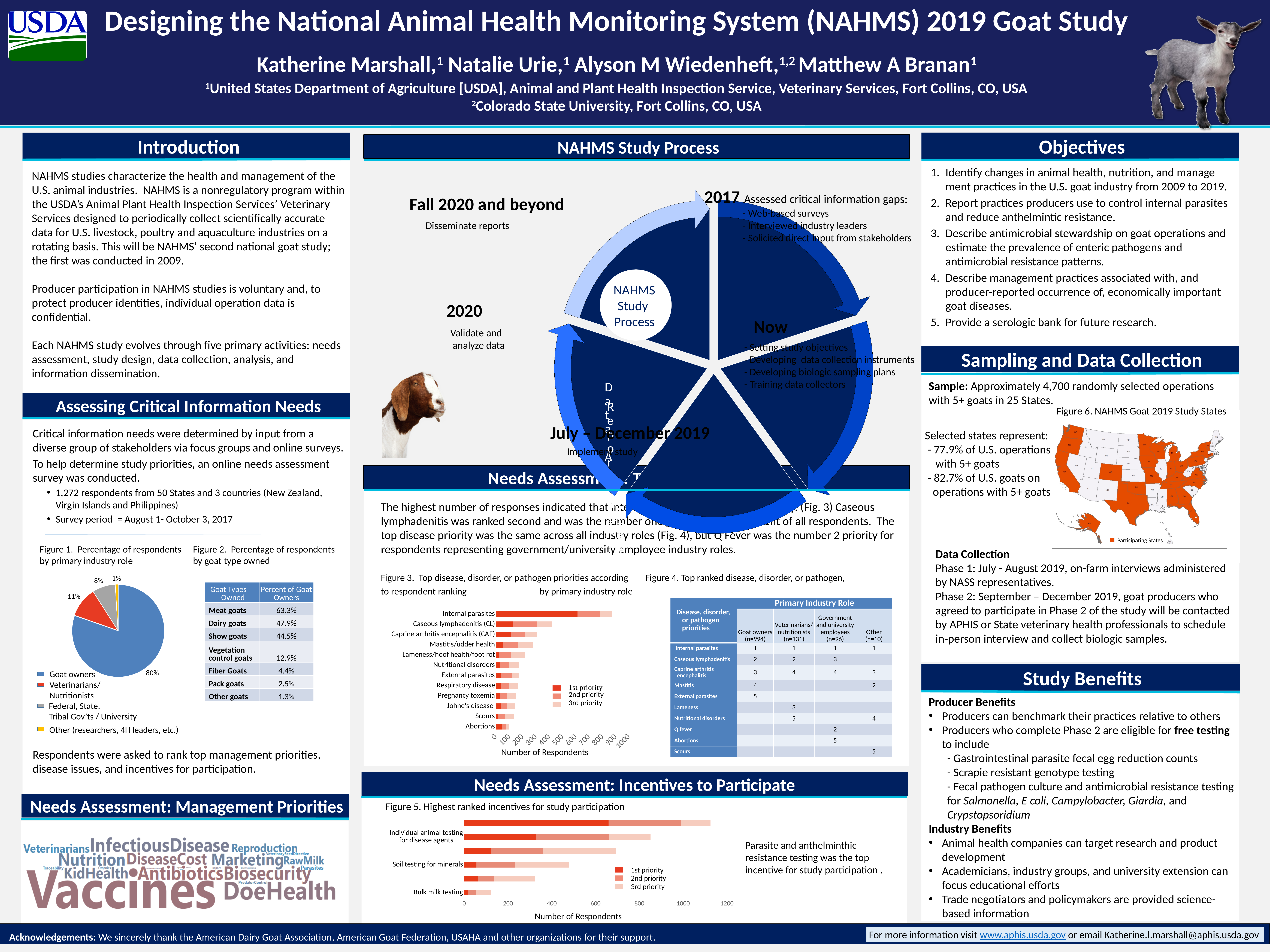
What kind of chart is Figure 3? Bar chart In Figure 1, what percentage of respondents were from Federal, State, Tribal Gov'ts / University? 8% In Figure 3, how many disease, disorder, or pathogen categories are listed? 12 What kind of chart is Figure 1? Pie chart In Figure 1, what percentage of respondents were goat owners? 80% In Figure 3, how many series does the legend list? 3 In Figure 3, which disease, disorder, or pathogen has the highest total number of respondents? Internal parasites In Figure 1, what is the difference in percentage points between goat owners and veterinarians/nutritionists? 69 In Figure 3, is the total number of respondents for Internal parasites greater or less than 800? greater In Figure 1, what percentage of respondents were veterinarians/nutritionists? 11% In Figure 1, which respondent group has the smallest share of the pie? Other (researchers, 4H leaders, etc.) In Figure 1, how many slices does the pie chart have? 4